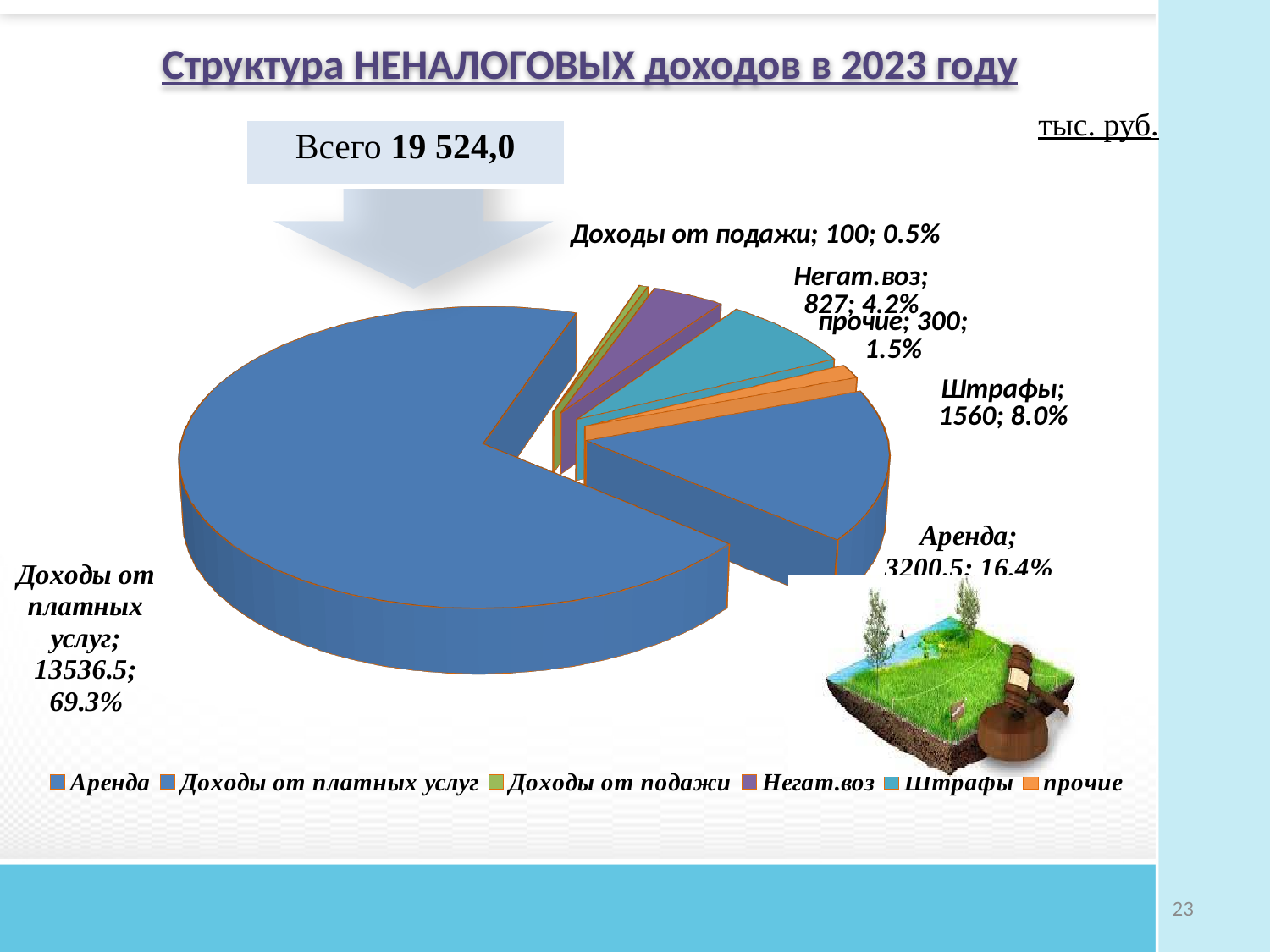
What share of the pie does Аренда represent? 16.4% What is the value for Негат.воз? 827 How many categories does the legend list? 6 What share of the pie does прочие represent? 1.5% Which is larger, the value for прочие or the value for Доходы от подажи? прочие What share of the pie does Доходы от платных услуг represent? 69.3% What is the value for Штрафы? 1560 What total value is shown above the chart (Всего)? 19 524,0 Which category has the smallest slice of the pie? Доходы от подажи What is the difference between the values for Штрафы and Негат.воз? 733 Which category has the largest slice of the pie? Доходы от платных услуг What kind of chart is shown on the slide? pie chart